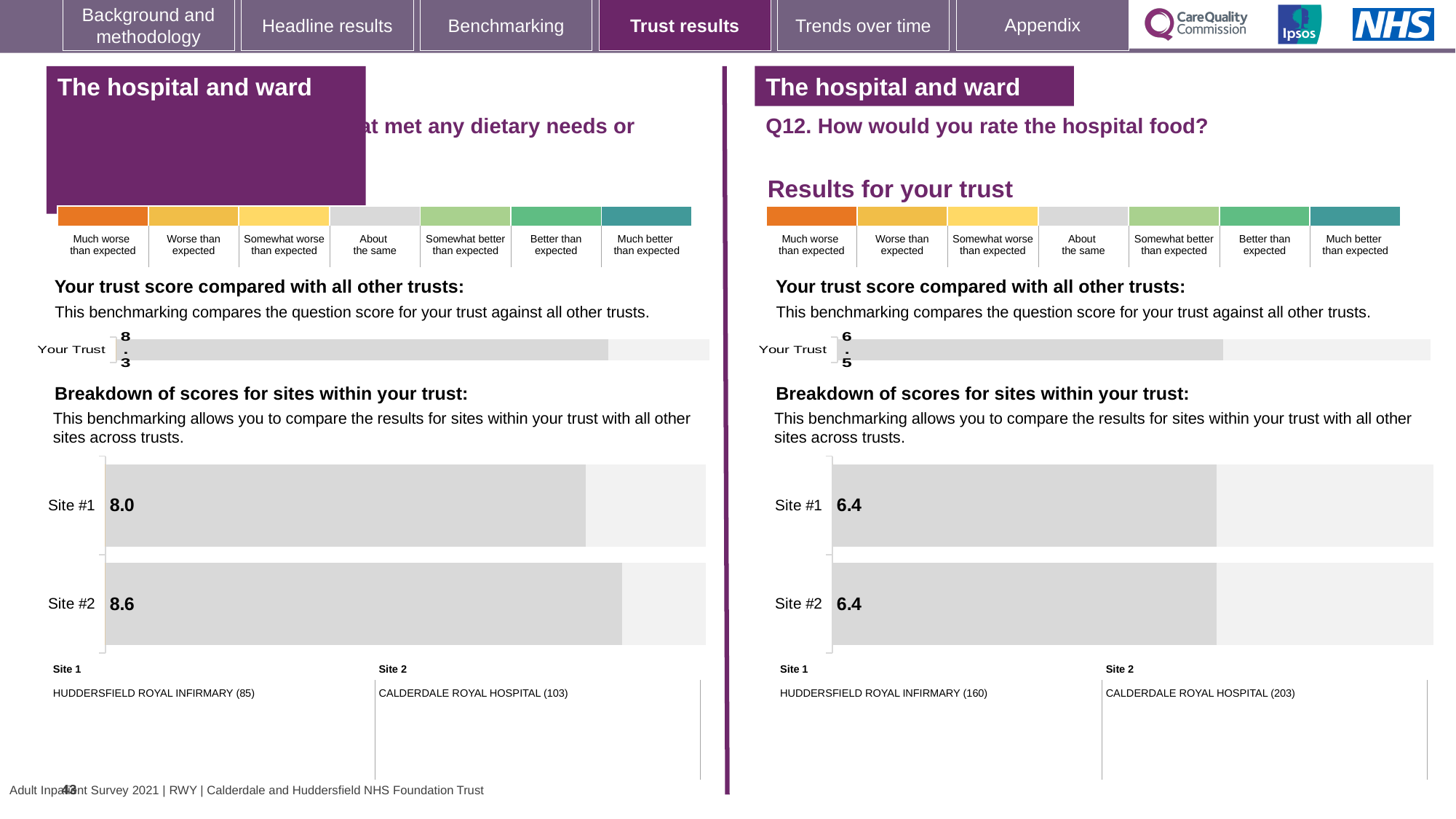
For Q12 (How would you rate the hospital food?), what is the score shown for Site #2 in the site breakdown chart? 6.4 On the left half of the slide, what is the 'Your Trust' score shown in the trust score comparison chart? 8.3 On the left half of the slide, what is the score shown for Site #1 in the breakdown of scores for sites within your trust? 8.0 Is the Site #1 score for Q12 (hospital food) larger or smaller than the Site #1 score on the left half of the slide? Smaller For Q12 (How would you rate the hospital food?), how many sites are shown in the site breakdown chart? 2 What type of chart is used for the breakdown of scores for sites within your trust on the right half of the slide? Bar chart On the left half of the slide, which site has the higher score in the breakdown of scores for sites within your trust? Site #2 For Q12 (How would you rate the hospital food?), what is the 'Your Trust' score shown in the trust score comparison chart? 6.5 For Q12 (How would you rate the hospital food?), what is the score shown for Site #1 in the site breakdown chart? 6.4 On the right half of the slide, which hospital is listed as Site 2 below the site breakdown chart? CALDERDALE ROYAL HOSPITAL (203) On the left half of the slide, what is the score shown for Site #2 in the breakdown of scores for sites within your trust? 8.6 On the left half of the slide, what is the difference between the Site #2 and Site #1 scores in the site breakdown chart? 0.6